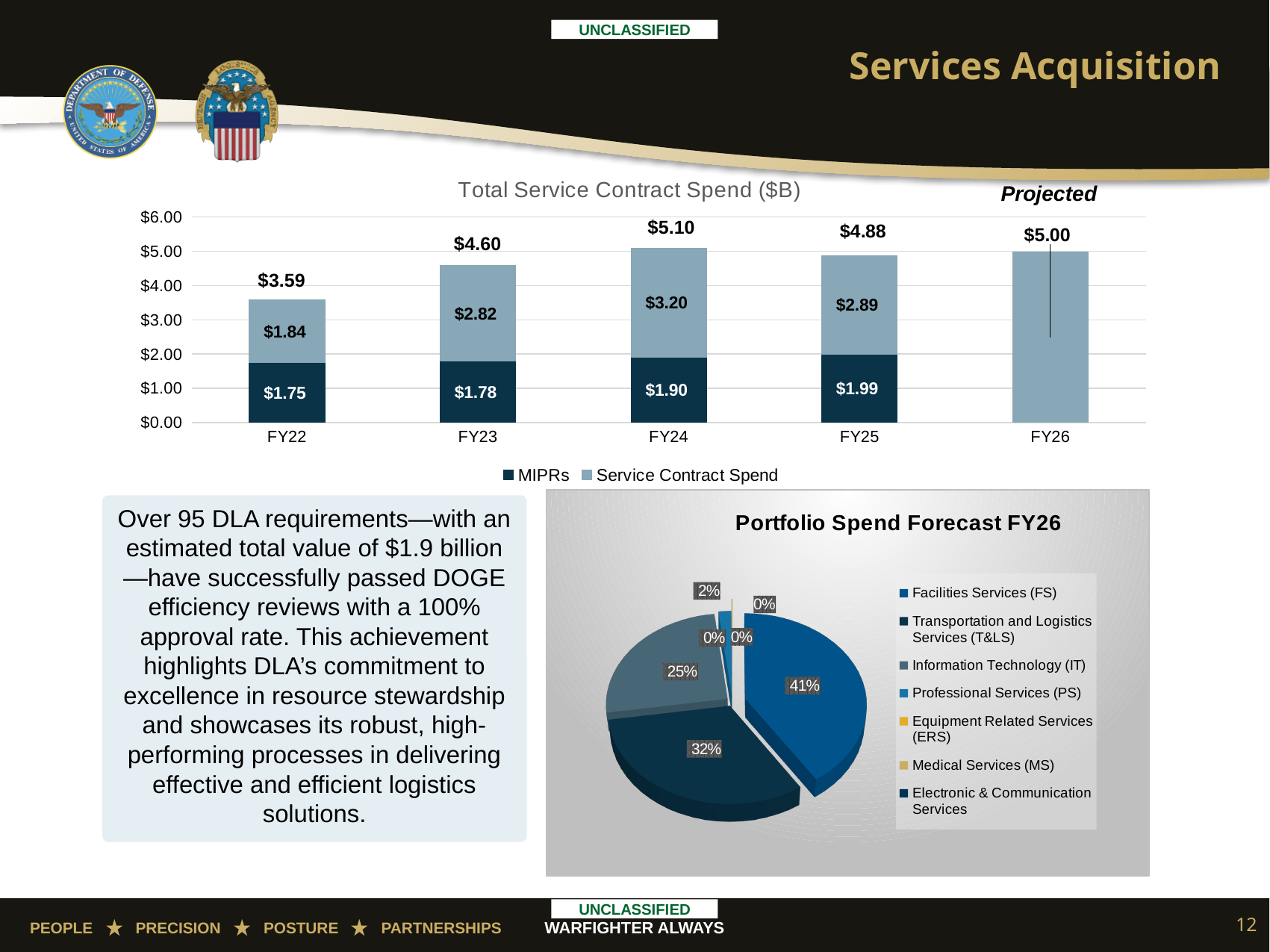
In the Total Service Contract Spend chart, which is larger for FY24: MIPRs or Service Contract Spend? Service Contract Spend In the Total Service Contract Spend chart, what is the MIPRs value for FY25? $1.99 In the Total Service Contract Spend chart, which fiscal year has the highest total spend? FY24 In the Total Service Contract Spend chart, how many series does the legend list? 2 In the Total Service Contract Spend chart, which fiscal year has the lowest total spend? FY22 In the Portfolio Spend Forecast FY26 chart, what share does Information Technology (IT) have? 25% In the Total Service Contract Spend chart, what is the projected total spend for FY26? $5.00 In the Total Service Contract Spend chart, what is the total spend for FY24? $5.10 In the Total Service Contract Spend chart, what is the Service Contract Spend value for FY23? $2.82 In the Total Service Contract Spend chart, what is the difference between the total spend in FY23 and FY22? $1.01 In the Portfolio Spend Forecast FY26 chart, what share does Facilities Services (FS) have? 41% What kind of chart is the Portfolio Spend Forecast FY26 chart? Pie chart